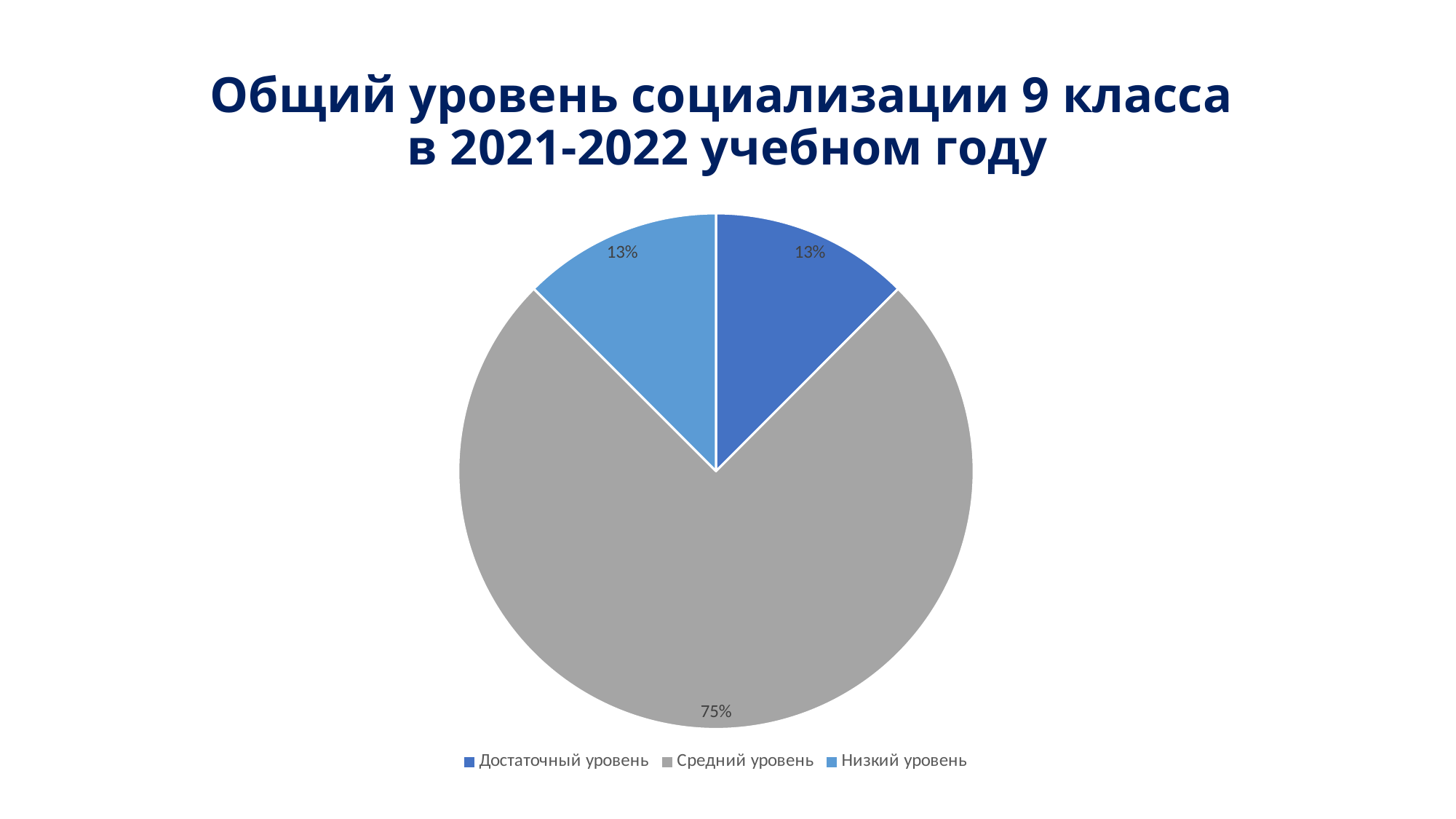
Which category has the largest slice of the pie? Средний уровень What is the combined share of "Достаточный уровень" and "Низкий уровень"? 25% How many slices does the pie chart have? 3 Which is larger: the slice for "Средний уровень" or the slice for "Достаточный уровень"? Средний уровень What is the title of the chart on the slide? Общий уровень социализации 9 класса в 2021-2022 учебном году How many entries does the legend list? 3 What is the value shown for "Достаточный уровень"? 13% What is the value shown for "Низкий уровень"? 13% What colour is the slice for "Средний уровень"? gray What type of chart is shown on the slide? pie chart What share of the pie does "Средний уровень" take? 75%